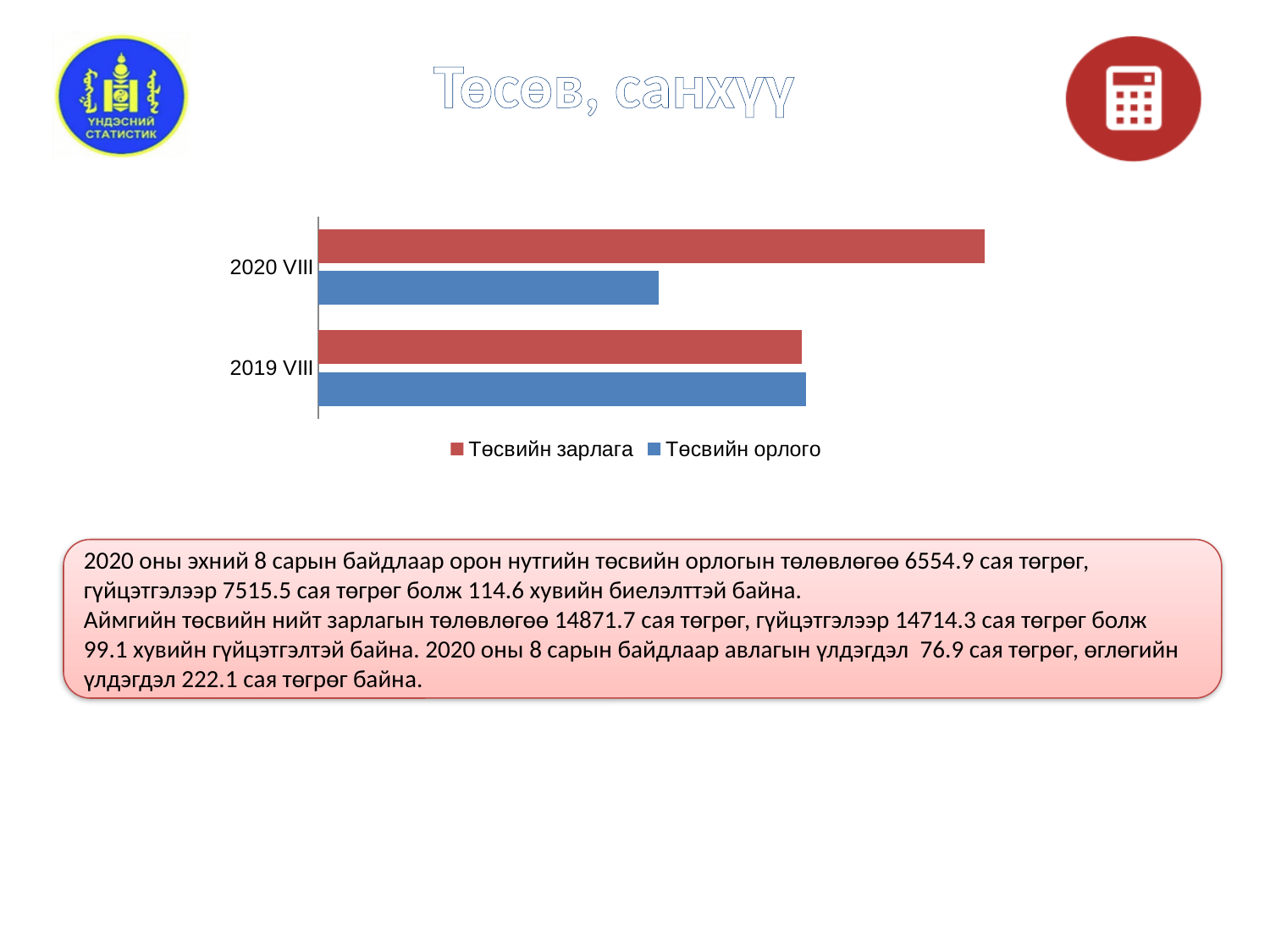
How many series does the chart's legend list? 2 Which bar is the shortest in the chart? Төсвийн орлого for 2020 VIII What kind of chart is shown on the slide? bar chart Which series is shown in red in the chart? Төсвийн зарлага For 2020 VIII, which is larger: Төсвийн зарлага or Төсвийн орлого? Төсвийн зарлага Which category has the lower value for Төсвийн орлого, 2020 VIII or 2019 VIII? 2020 VIII Which series is shown in blue in the chart? Төсвийн орлого Which bar is the longest in the chart? Төсвийн зарлага for 2020 VIII Does Төсвийн орлого rise or fall from 2019 VIII to 2020 VIII? fall How many categories are shown on the chart's vertical axis? 2 Which category has the higher value for Төсвийн зарлага, 2020 VIII or 2019 VIII? 2020 VIII Does Төсвийн зарлага rise or fall from 2019 VIII to 2020 VIII? rise